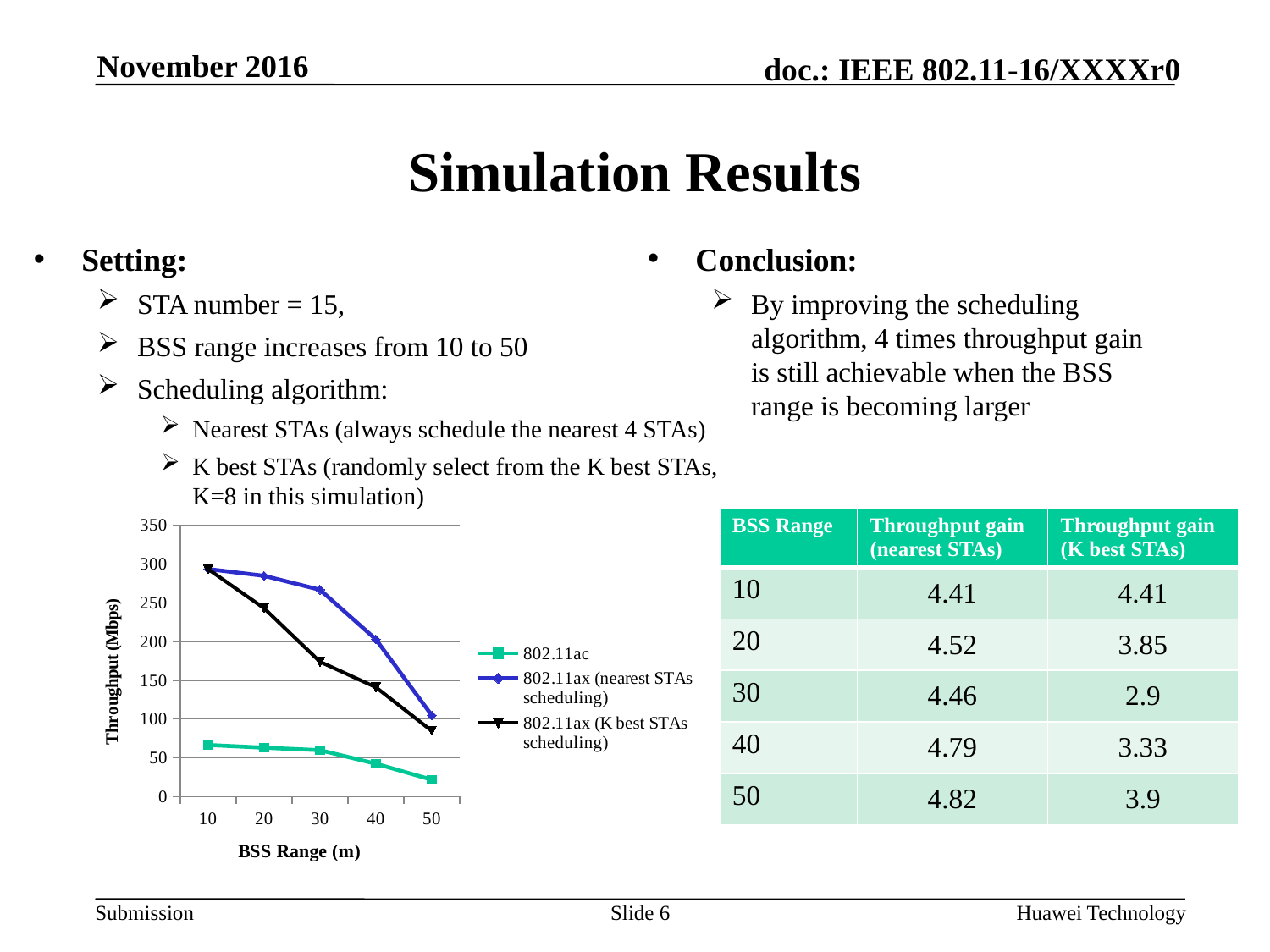
Is the throughput for 802.11ax (nearest STAs scheduling) at BSS Range 30 greater or less than 250? greater Is the throughput for 802.11ax (nearest STAs scheduling) at BSS Range 50 greater or less than 150? less Does the throughput of 802.11ax (nearest STAs scheduling) rise or fall as BSS Range increases from 10 to 50? fall Is the throughput for 802.11ac at BSS Range 10 greater or less than 100? less How many BSS Range values are plotted along the x axis of the chart? 5 At BSS Range 30, which series has the higher throughput: 802.11ax (nearest STAs scheduling) or 802.11ax (K best STAs scheduling)? 802.11ax (nearest STAs scheduling) How many series does the chart legend list? 3 At BSS Range 40, which series has the higher throughput: 802.11ac or 802.11ax (K best STAs scheduling)? 802.11ax (K best STAs scheduling) What kind of chart is shown on the slide? line chart What is the label of the chart's vertical axis? Throughput (Mbps)